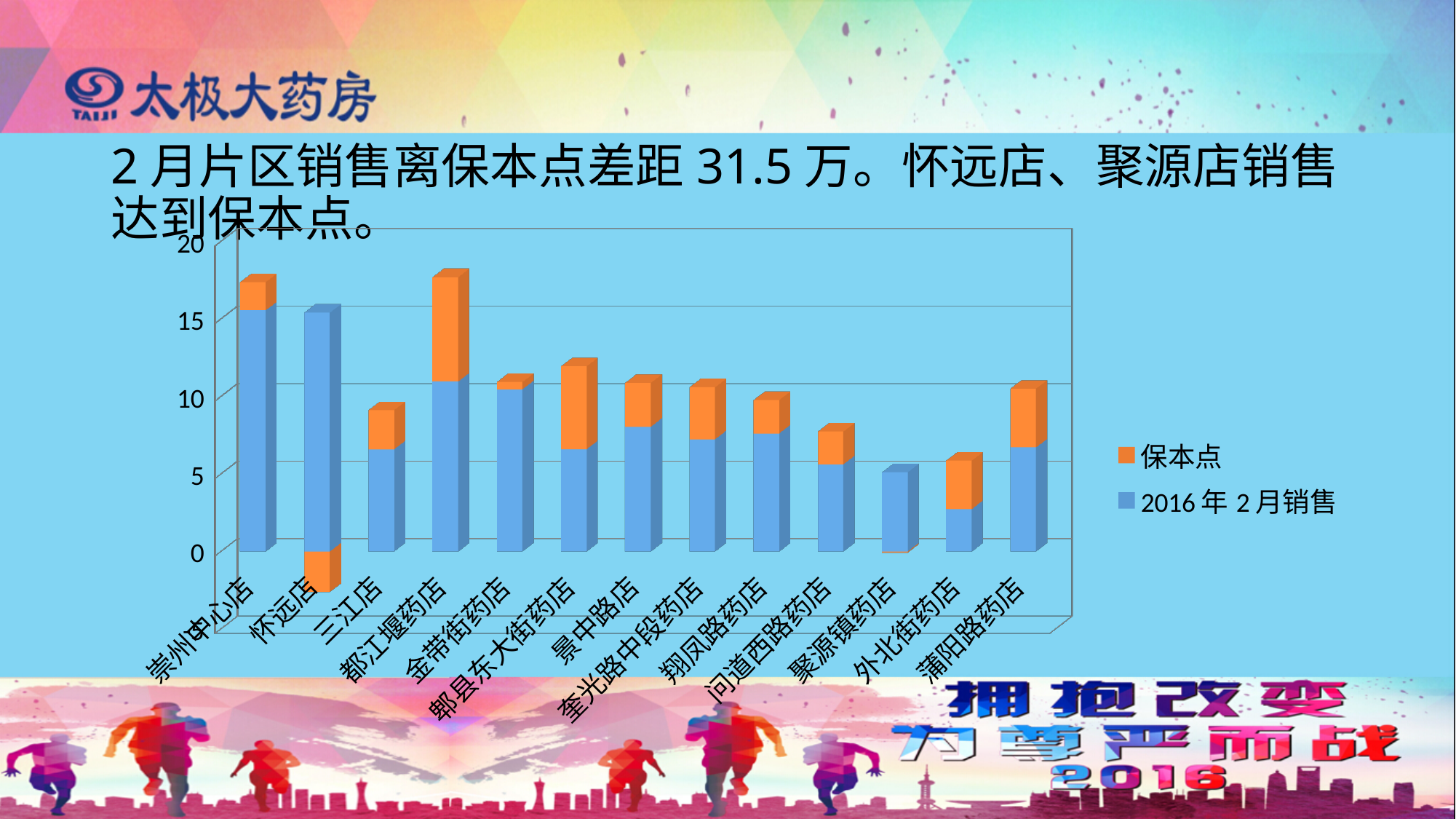
Is the 2016年2月销售 value for 崇州中心店 greater or less than 10? greater Which store has the larger 2016年2月销售 value, 崇州中心店 or 三江店? 崇州中心店 What are the two series named in the chart legend? 保本点 and 2016年2月销售 Is the 2016年2月销售 value for 外北街药店 greater or less than 5? less How many series does the chart legend list? 2 Is the 2016年2月销售 value for 三江店 greater or less than 5? greater Which colour represents the 保本点 series in the chart? orange What kind of chart is shown on the slide? bar chart Which store has the larger 2016年2月销售 value, 蒲阳路药店 or 外北街药店? 蒲阳路药店 How many stores (categories) are shown on the x axis of the chart? 13 Which store has the lowest 2016年2月销售 value? 外北街药店